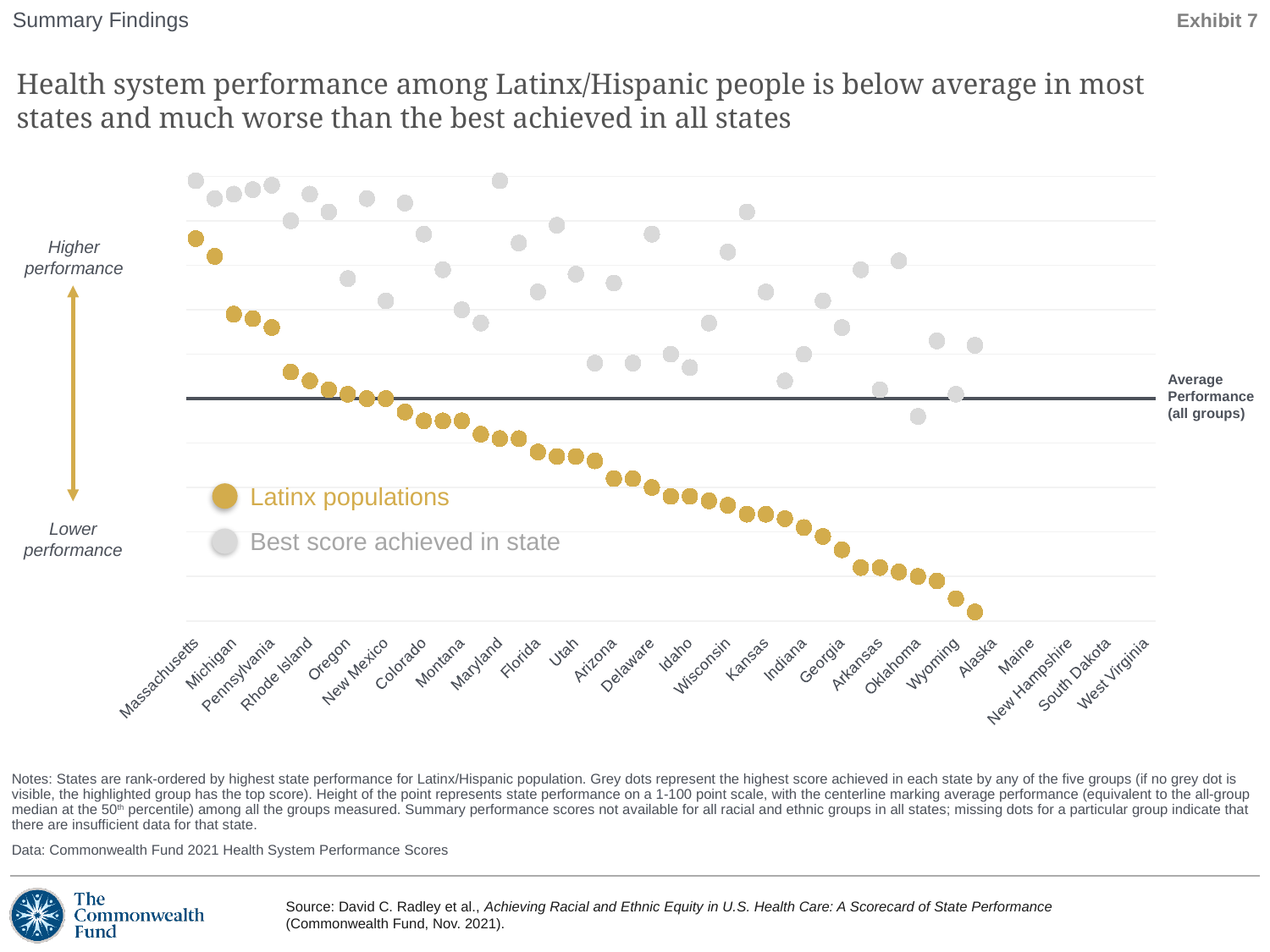
What are the two series named in the legend? Latinx populations; Best score achieved in state What kind of chart is shown on the slide? Dot (scatter) chart Is the Latinx populations score for Kansas above or below the Average Performance (all groups) line? Below Which state has the higher Latinx populations score, Massachusetts or Michigan? Massachusetts Is the Latinx populations score for Massachusetts above or below the Average Performance (all groups) line? Above How many state labels are printed along the x axis? 26 Which colour represents the Latinx populations series? Gold Which state label appears first (leftmost) on the x axis? Massachusetts Which state has the highest Latinx population performance score? Massachusetts How many series does the legend list? 2 Do the Latinx population values rise or fall moving left to right along the x axis? Fall